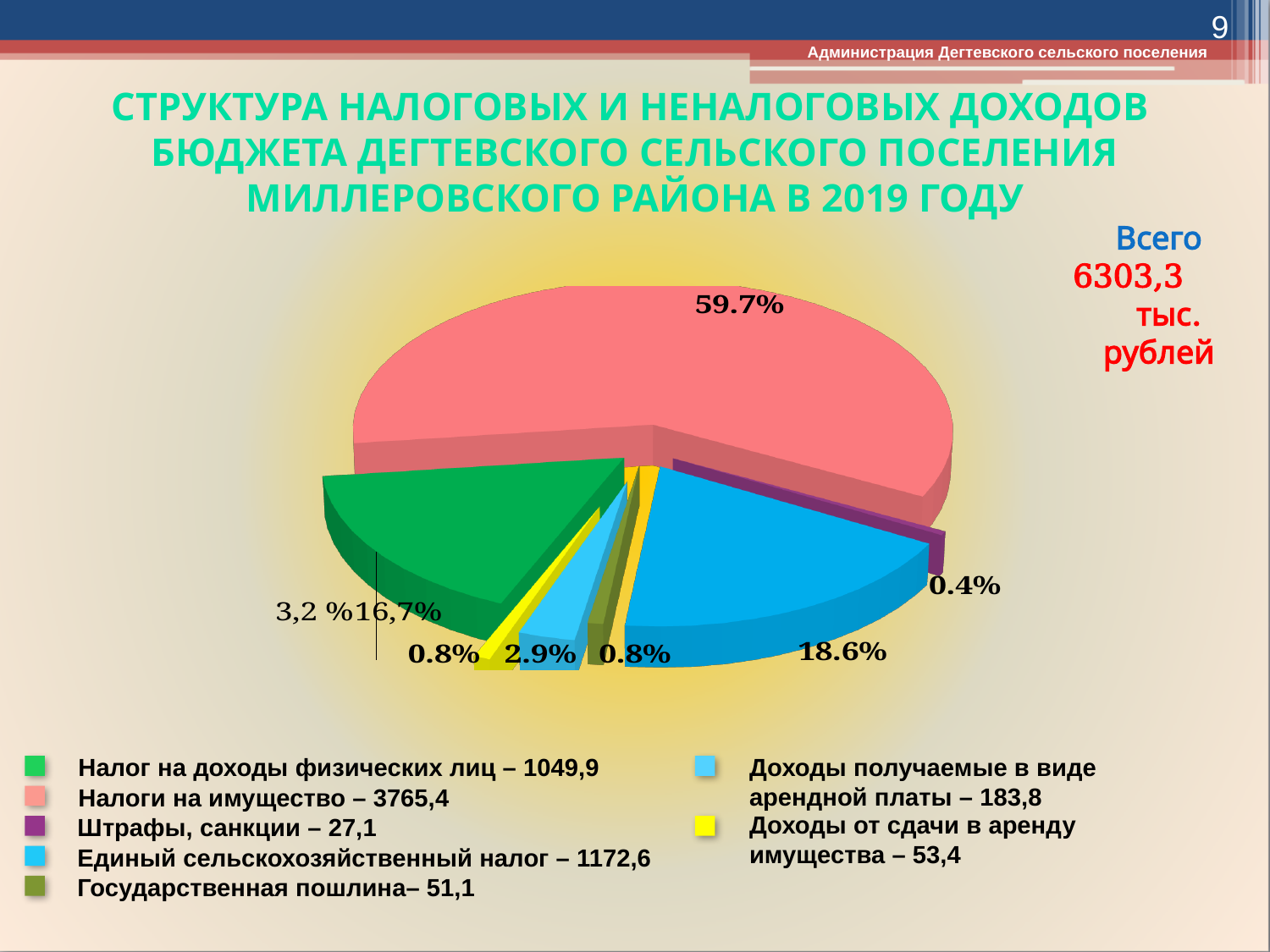
What percentage of the pie does Налог на доходы физических лиц account for? 16,7% Which category has the largest slice of the pie? Налоги на имущество What value does the legend give for Государственная пошлина? 51,1 What percentage of the pie does Единый сельскохозяйственный налог account for? 18.6% What kind of chart is shown on the slide? pie chart What total (Всего) is stated next to the chart? 6303,3 тыс. рублей What value does the legend give for Штрафы, санкции? 27,1 Which category has the smallest slice of the pie? Штрафы, санкции What percentage of the pie does Налоги на имущество account for? 59.7% How many categories does the legend list? 7 Which slice is larger: Единый сельскохозяйственный налог or Налог на доходы физических лиц? Единый сельскохозяйственный налог What value does the legend give for Доходы получаемые в виде арендной платы? 183,8